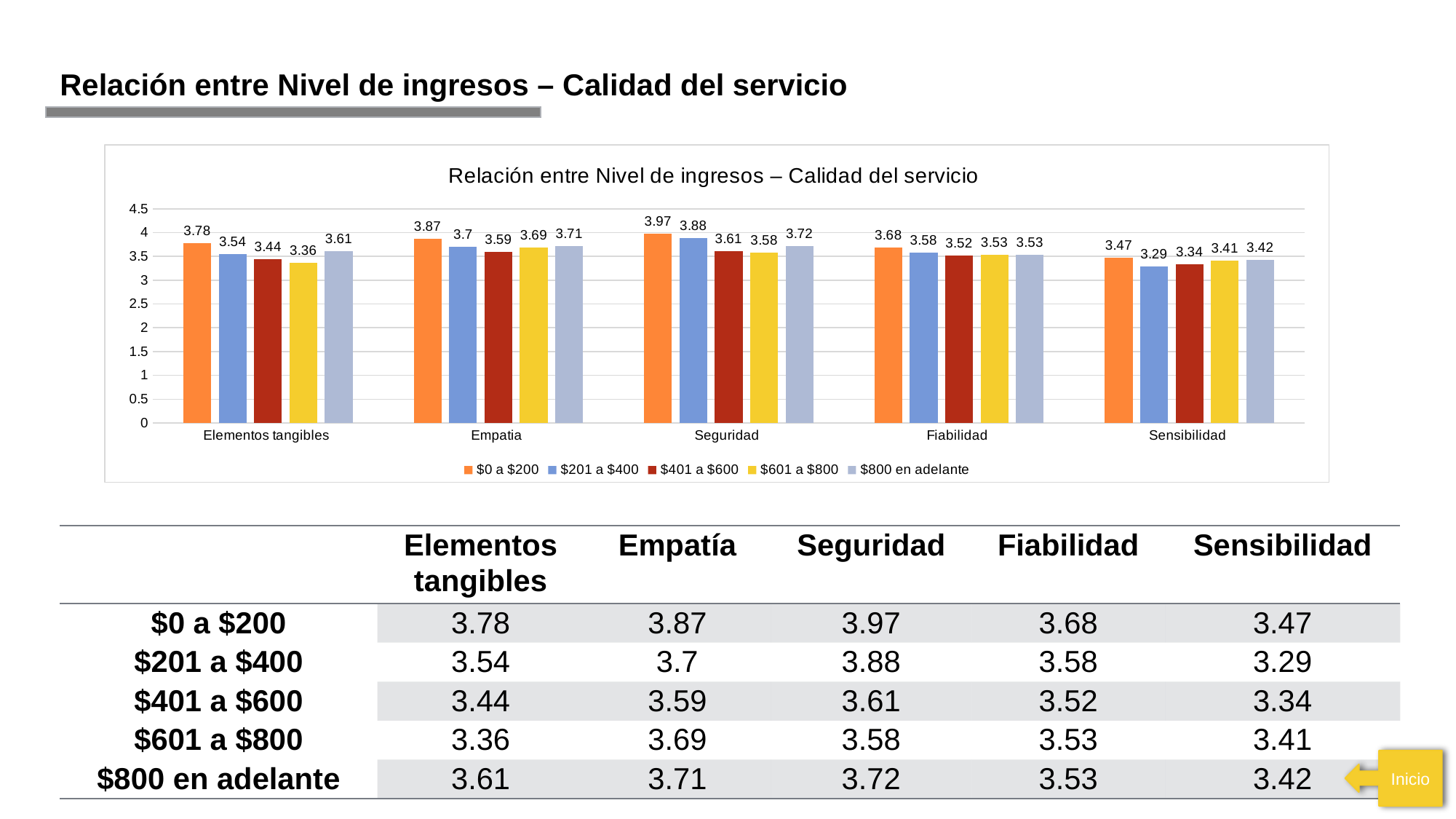
How many series does the chart legend list? 5 What is the title of the chart? Relación entre Nivel de ingresos – Calidad del servicio What kind of chart is shown on the slide? Bar chart What is the value for the $0 a $200 series in the Seguridad category? 3.97 What is the difference between the $0 a $200 and $201 a $400 values in the Elementos tangibles category? 0.24 Is the value for the $401 a $600 series in the Sensibilidad category greater or less than 3.5? less How many categories are shown on the x axis of the chart? 5 Which category has the highest value for the $201 a $400 series? Seguridad What is the value for the $800 en adelante series in the Empatia category? 3.71 Which is larger in the Fiabilidad category: the $0 a $200 value or the $800 en adelante value? $0 a $200 What is the value for the $601 a $800 series in the Elementos tangibles category? 3.36 Which category has the lowest value for the $0 a $200 series? Sensibilidad